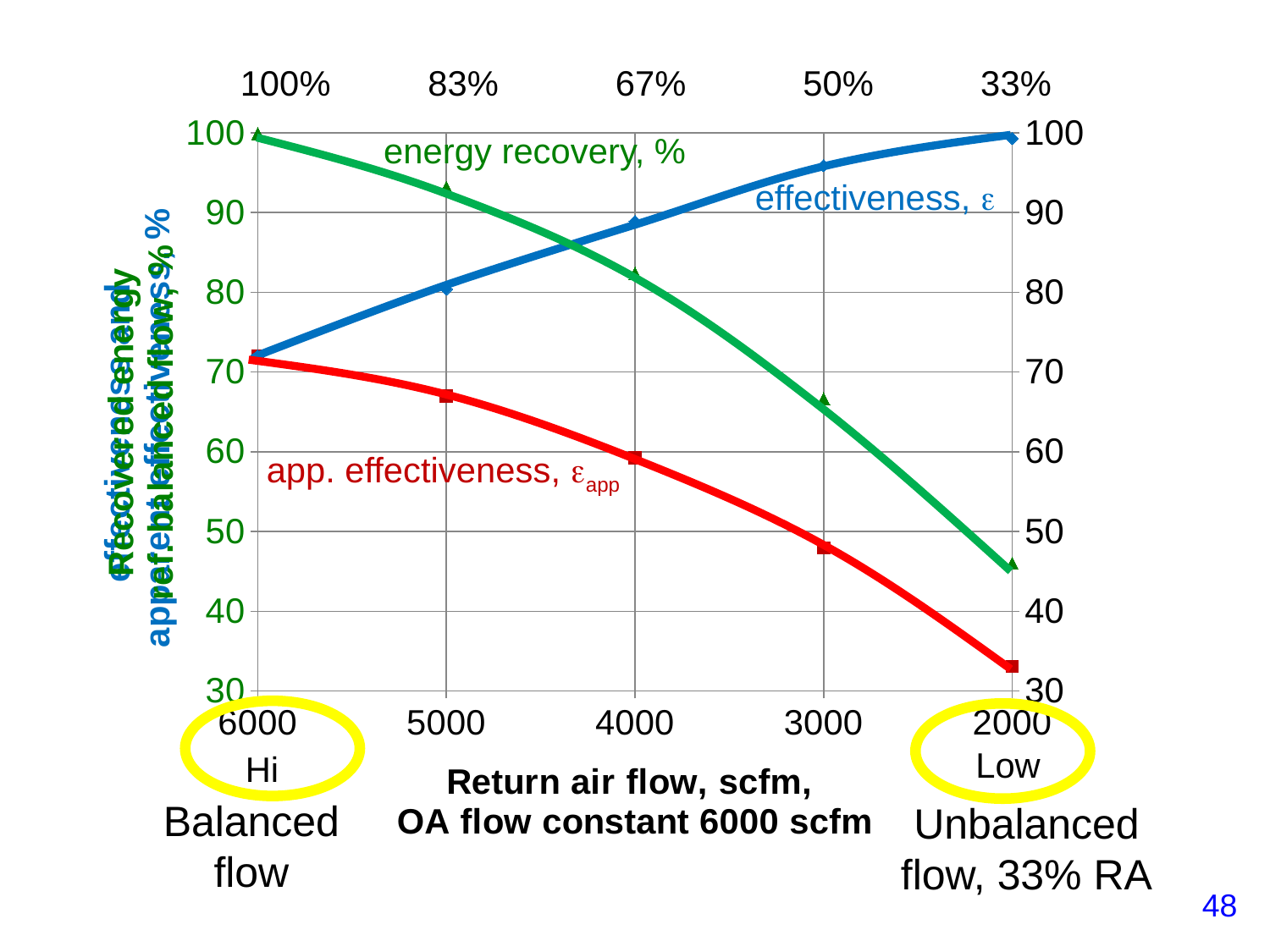
At 3000 scfm, which is larger: energy recovery or app. effectiveness? energy recovery Does effectiveness, ε rise or fall as return air flow goes from 6000 to 2000 scfm? rise What is the x-axis title of the chart? Return air flow, scfm, OA flow constant 6000 scfm Is the app. effectiveness at 2000 scfm greater or less than 40? less Is the effectiveness, ε at 4000 scfm greater or less than 80? greater Is the app. effectiveness at 3000 scfm greater or less than 40? greater Does energy recovery rise or fall as return air flow goes from 6000 to 2000 scfm? fall What kind of chart is shown on the slide? line chart How many return air flow values are plotted along the x axis? 5 How many data series are plotted on the chart? 3